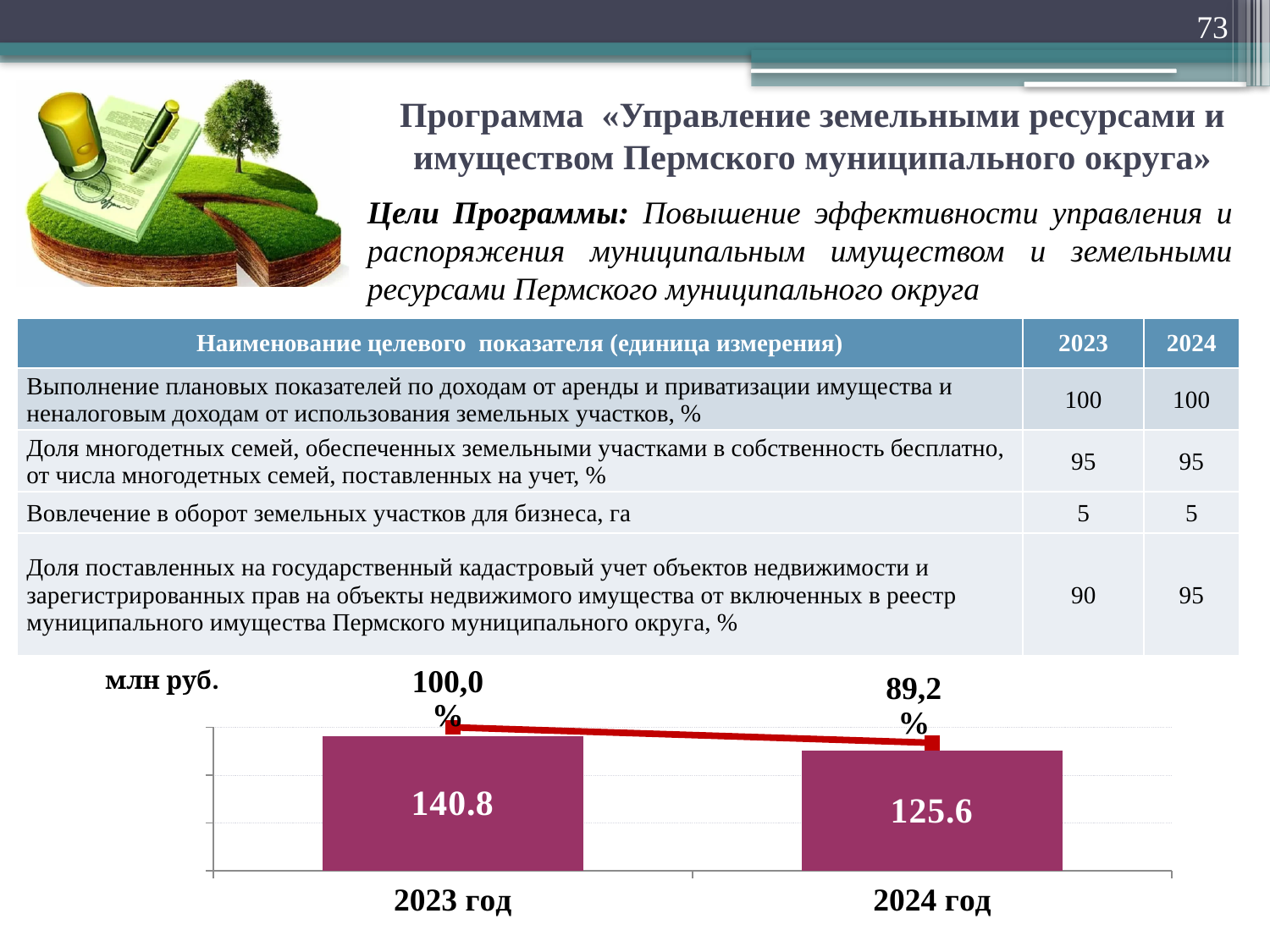
How many bars are plotted in the chart? 2 What is the difference between the 2023 год and 2024 год bar values? 15.2 What is the value for 2023 год in the bar chart? 140.8 Is the bar value for 2023 год larger or smaller than the bar value for 2024 год? larger What is the value for 2024 год in the bar chart? 125.6 Which year has the higher bar in the chart? 2023 год Do the bar values rise or fall from 2023 год to 2024 год? fall What unit is indicated at the top left of the chart? млн руб. What kind of chart is shown at the bottom of the slide? combination bar and line chart Which year has the lower bar in the chart? 2024 год What percentage label is shown on the line above the 2023 год bar? 100,0 % What percentage label is shown on the line above the 2024 год bar? 89,2 %